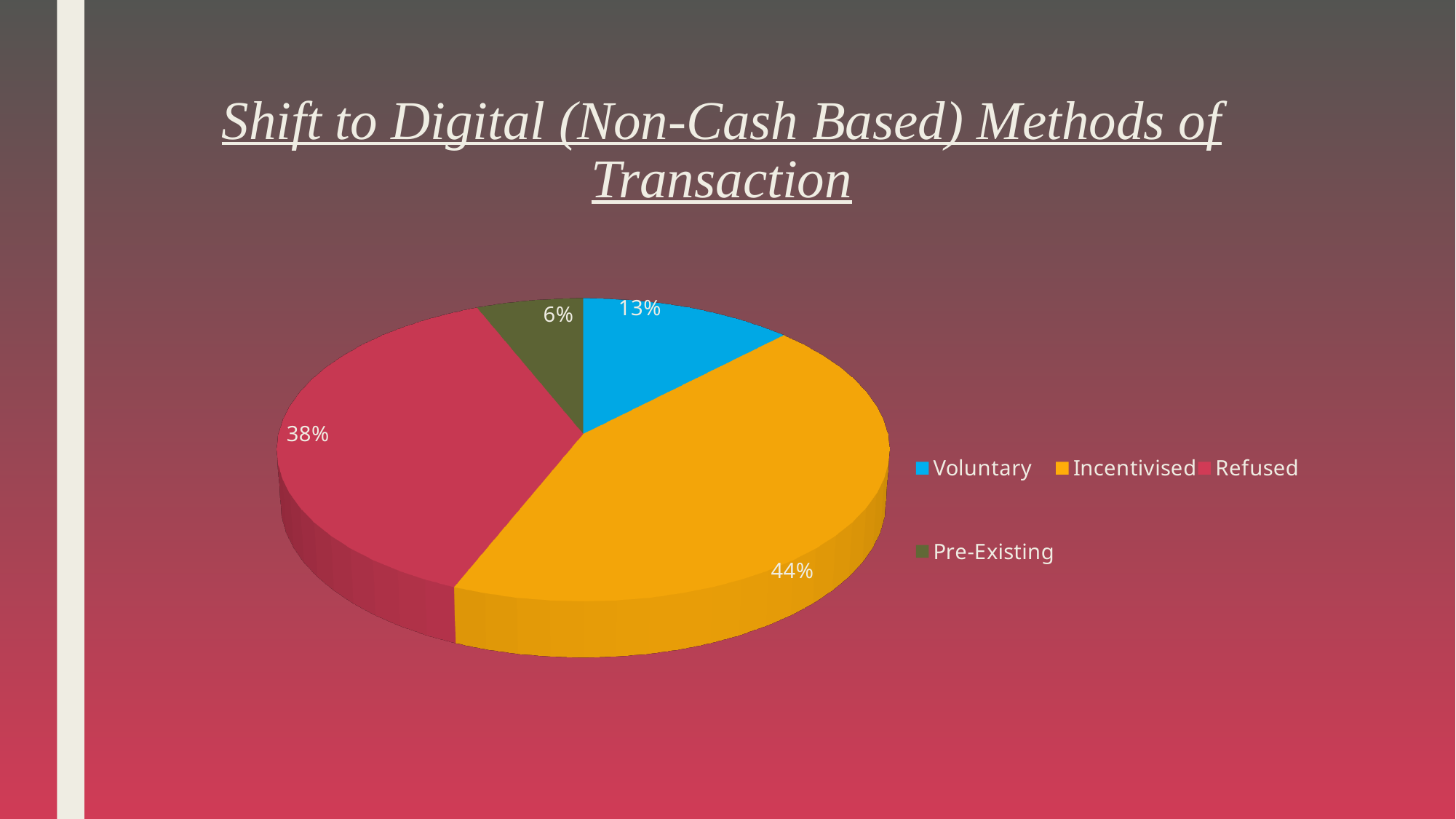
Which is larger, the Voluntary slice or the Refused slice? Refused What kind of chart is shown on the slide? Pie chart What share of the pie is Refused? 38% What is the difference in percentage points between the Voluntary and Pre-Existing slices? 7 What share of the pie is Incentivised? 44% What is the difference in percentage points between the Incentivised and Refused slices? 6 How many categories does the pie chart show? 4 Which category has the smallest slice of the pie? Pre-Existing What share of the pie is Pre-Existing? 6% Which category has the largest slice of the pie? Incentivised What colour is the Refused slice in the pie chart? Red